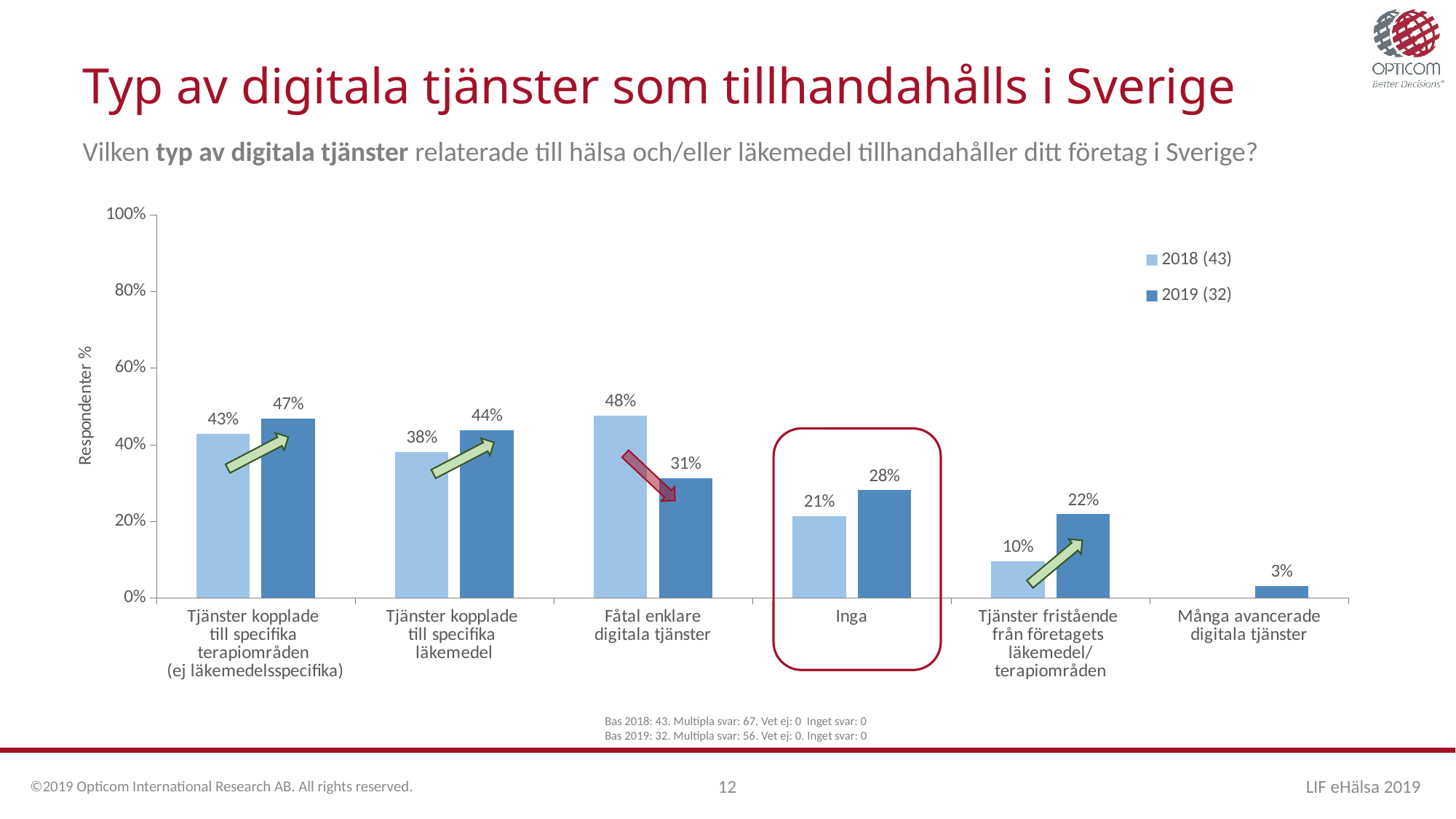
Which category has the highest 2019 (32) value? Tjänster kopplade till specifika terapiområden (ej läkemedelsspecifika) For "Tjänster kopplade till specifika läkemedel", which is larger: the 2018 (43) value or the 2019 (32) value? 2019 (32) What is the 2018 (43) value for "Fåtal enklare digitala tjänster"? 48% How many categories are shown on the x axis? 6 How many series does the legend list? 2 Is the 2019 (32) value for "Tjänster fristående från företagets läkemedel/terapiområden" greater or less than 20%? greater Which category has the lowest 2018 (43) value among those with a 2018 bar? Tjänster fristående från företagets läkemedel/terapiområden What is the label of the y axis? Respondenter % What is the 2019 (32) value for "Inga"? 28% What is the 2019 (32) value for "Många avancerade digitala tjänster"? 3% What kind of chart is shown on the slide? Bar chart What is the difference between the 2018 (43) and 2019 (32) values for "Fåtal enklare digitala tjänster"? 17 percentage points